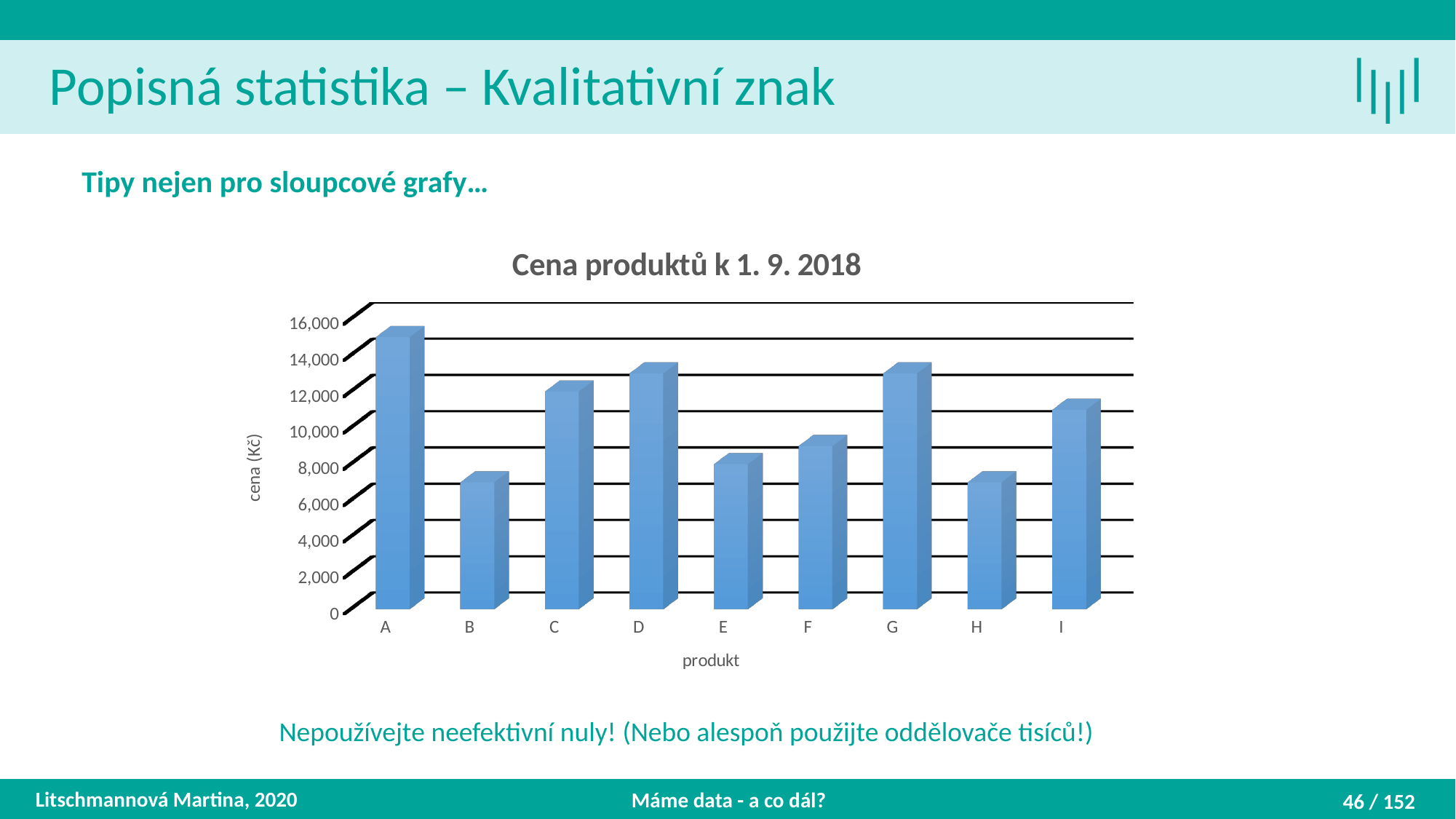
What type of chart is shown on the slide? bar chart Which has the larger value, product H or product D? D What is the title of the chart? Cena produktů k 1. 9. 2018 Is the value for product B greater or less than 8,000? less Is the value for product A greater or less than 14,000? greater Which has the larger value, product C or product E? C Which product has the highest price in the chart? A Is the value for product C greater or less than 10,000? greater What is the label of the vertical axis of the chart? cena (Kč) How many products (categories) are shown on the x axis of the chart? 9